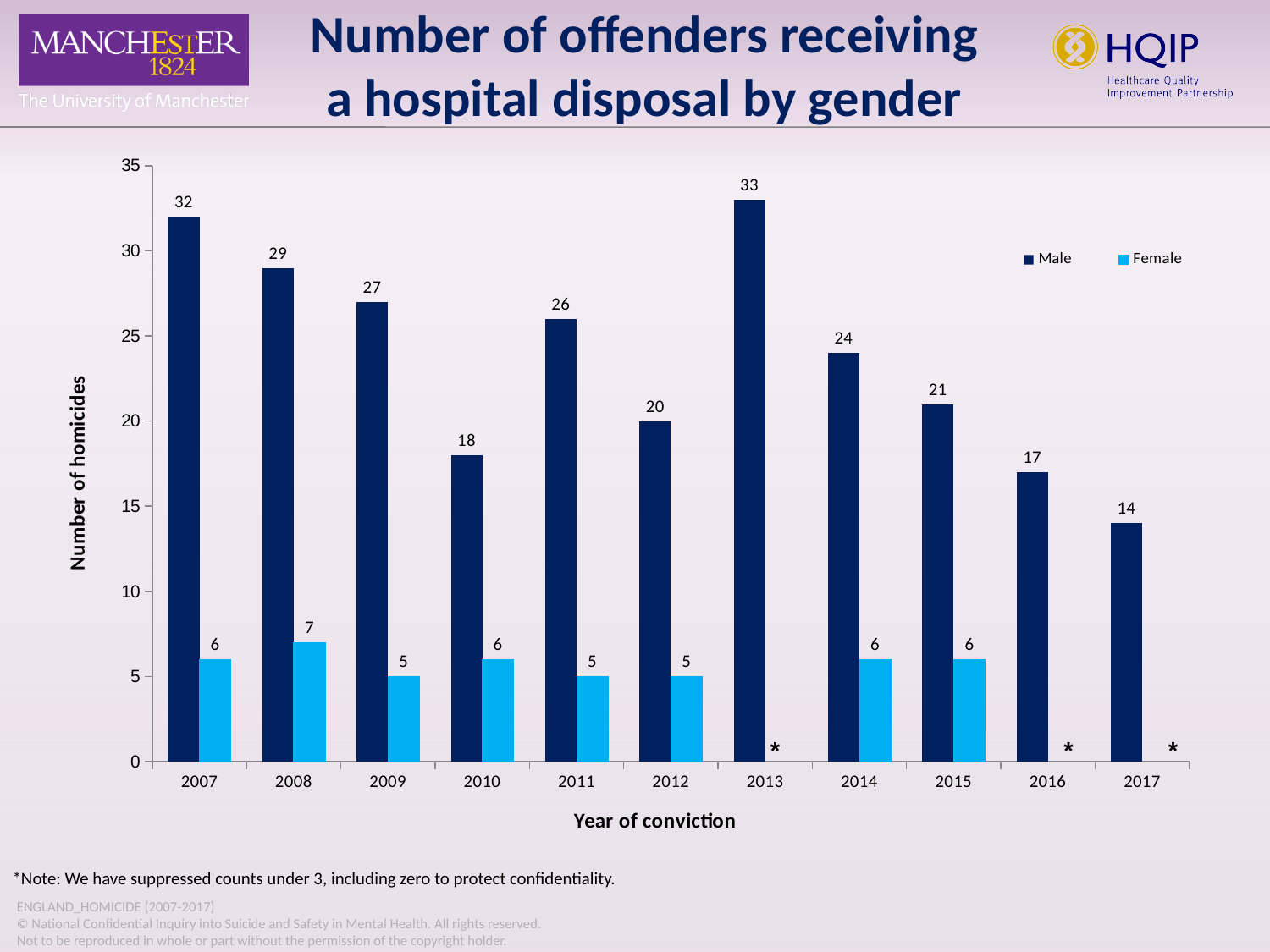
How many series does the legend list? 2 What does the asterisk on the chart indicate, according to the note? Counts under 3, including zero, have been suppressed to protect confidentiality What kind of chart is shown on the slide? Bar chart Which is larger, the Male value in 2010 or the Male value in 2012? 2012 What is the value for Male in 2017? 14 How many years of conviction are shown on the x axis? 11 Which year has the lowest number of male offenders receiving a hospital disposal? 2017 Which year has the highest number of male offenders receiving a hospital disposal? 2013 What is the number of female offenders receiving a hospital disposal in 2008? 7 Is the Male value for 2014 greater or less than 20? greater What is the number of male offenders receiving a hospital disposal in 2013? 33 What is the difference between the Male and Female values in 2007? 26